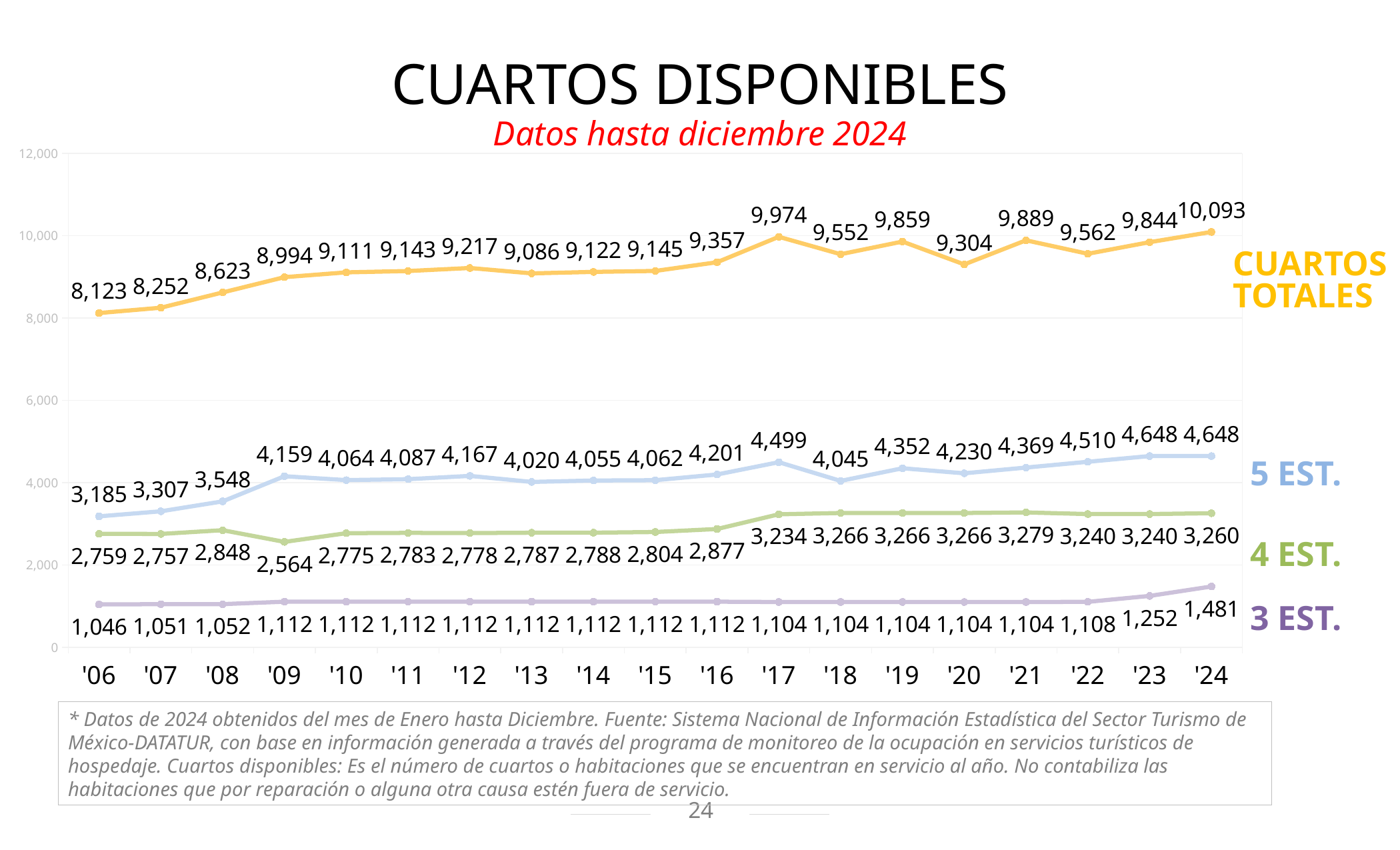
By how much did CUARTOS TOTALES increase from '06 to '24? 1,970 How many series are plotted on the chart? 4 Which year has the larger 5 EST. value, '17 or '18? '17 What kind of chart is shown on the slide? Line chart In which year is CUARTOS TOTALES highest? '24 What is the value of the 3 EST. series in '23? 1,252 What is the difference between the 3 EST. values in '24 and '23? 229 How many years are shown on the x axis? 19 What is the value of the 5 EST. series in '17? 4,499 What is the value of CUARTOS TOTALES in '24? 10,093 In which year is the 4 EST. series lowest? '09 Does the 3 EST. series rise or fall from '22 to '24? Rise